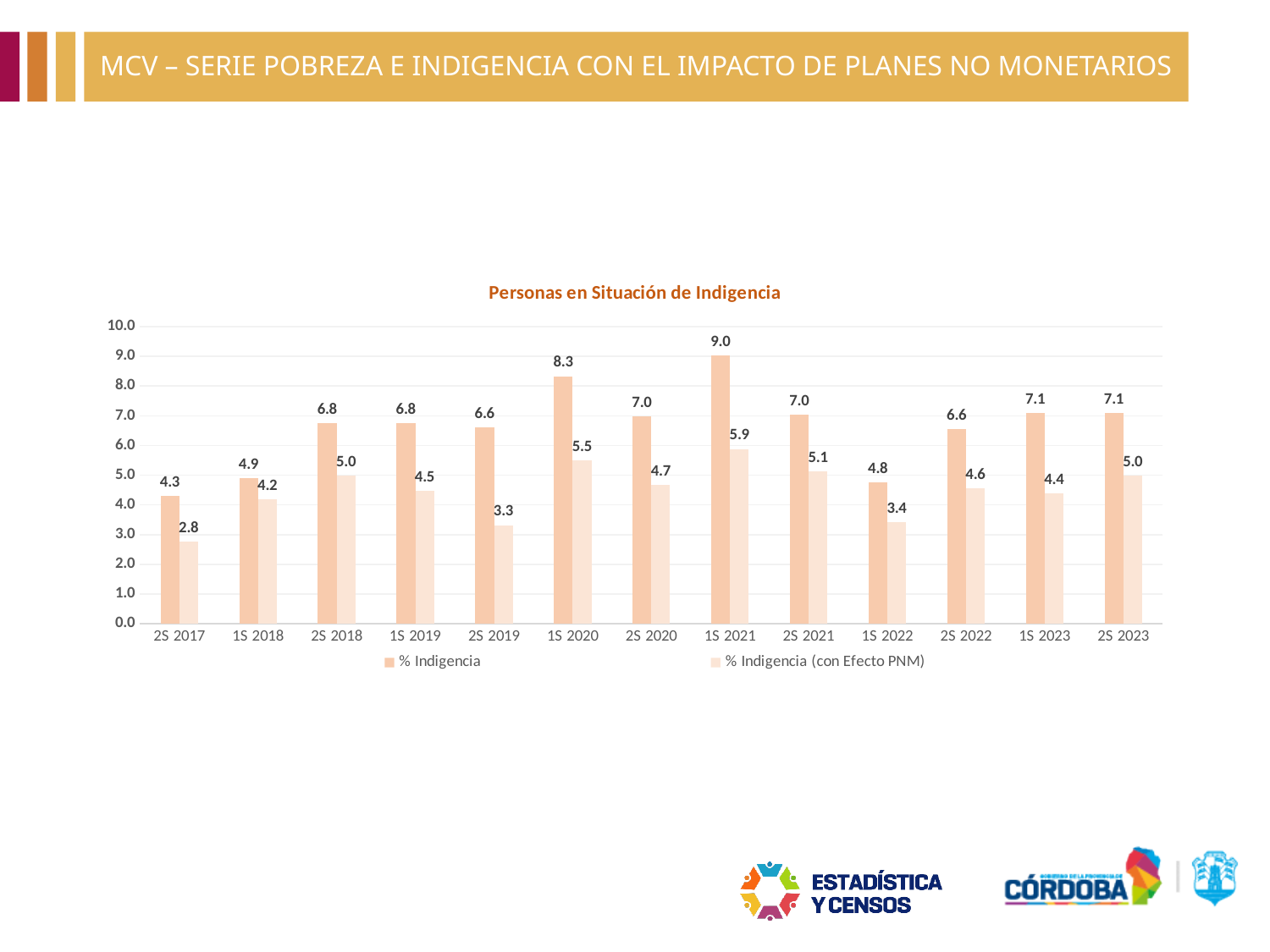
Which is larger: the % Indigencia value for 1S 2020 or for 2S 2020? 1S 2020 What is the difference between the % Indigencia values for 2S 2018 and 1S 2018? 1.9 What is the % Indigencia (con Efecto PNM) value for 2S 2019? 3.3 What is the difference between % Indigencia and % Indigencia (con Efecto PNM) in 1S 2021? 3.1 What is the % Indigencia value for 1S 2021? 9.0 What is the title of the chart? Personas en Situación de Indigencia How many periods are shown on the x axis? 13 Is the % Indigencia value for 2S 2017 greater or less than 5.0? less Which period has the highest % Indigencia value? 1S 2021 Which period has the lowest % Indigencia (con Efecto PNM) value? 2S 2017 What kind of chart is shown? bar chart How many series does the legend list? 2